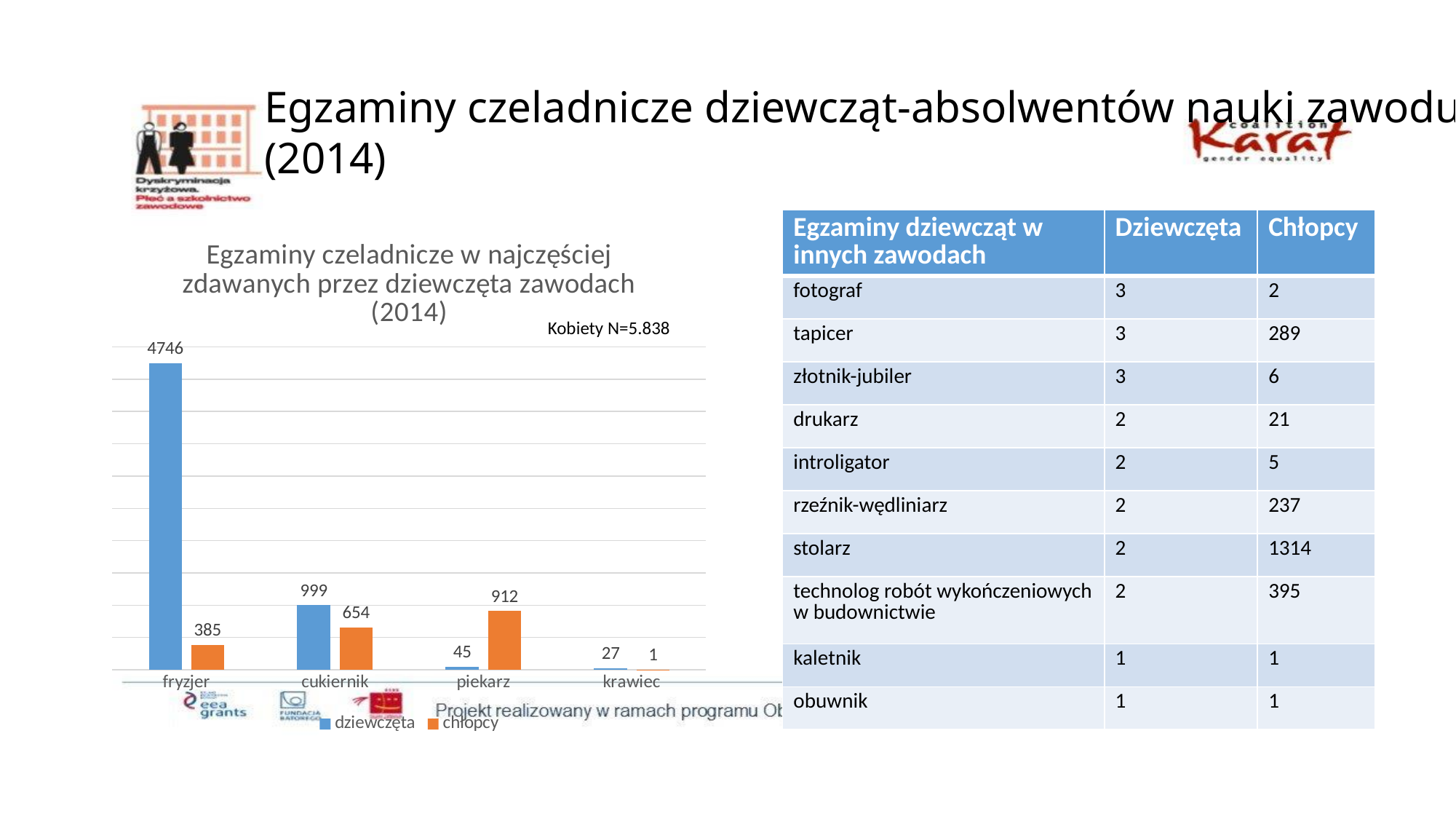
In the piekarz category, which series has the larger value, dziewczęta or chłopcy? chłopcy What is the value for chłopcy in the piekarz category? 912 What is the sample size noted on the chart for Kobiety? N=5.838 What is the value for dziewczęta in the krawiec category? 27 Which category has the lowest value for chłopcy? krawiec What is the difference between the dziewczęta and chłopcy values in the fryzjer category? 4361 What is the value for chłopcy in the cukiernik category? 654 Which category has the highest value for dziewczęta? fryzjer How many series does the chart legend list? 2 What is the value for dziewczęta in the fryzjer category? 4746 What kind of chart is shown on the slide? bar chart How many categories are shown on the x axis of the chart? 4